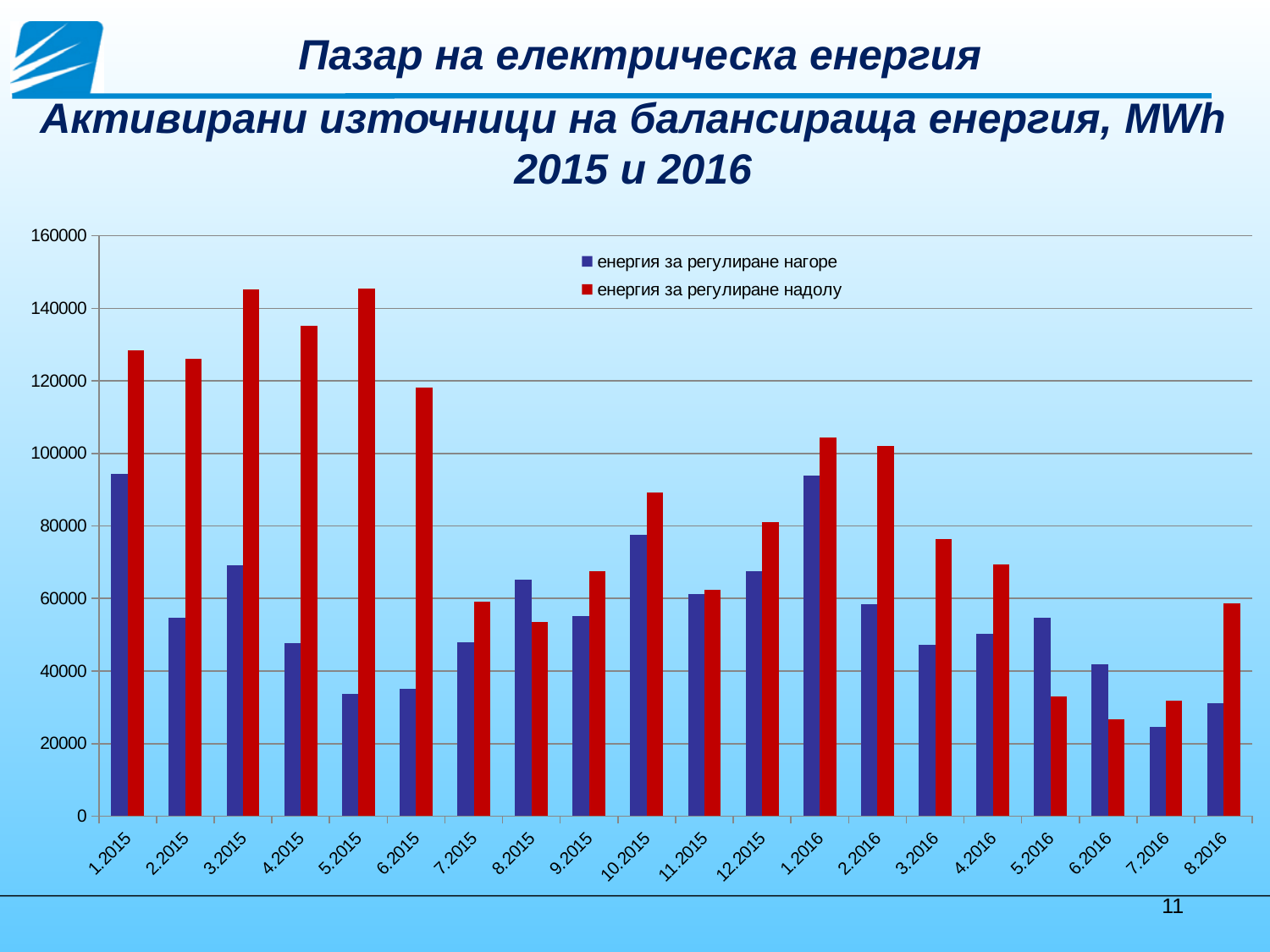
What kind of chart is shown on the slide? bar chart Is the value for енергия за регулиране нагоре in 5.2015 greater or less than 40000? less Is the value for енергия за регулиране надолу in 4.2015 greater or less than 120000? greater How many categories (months) are shown on the x axis? 20 In which month is the value for енергия за регулиране нагоре lowest? 7.2016 In 8.2015, which series has the larger value, енергия за регулиране нагоре or енергия за регулиране надолу? енергия за регулиране нагоре Which series is shown in red? енергия за регулиране надолу In which month is the value for енергия за регулиране надолу lowest? 6.2016 In 3.2015, which series has the larger value, енергия за регулиране нагоре or енергия за регулиране надолу? енергия за регулиране надолу Do the values for енергия за регулиране надолу rise or fall from 1.2016 to 7.2016? fall How many series does the legend list? 2 Is the value for енергия за регулиране надолу in 1.2015 greater or less than 120000? greater